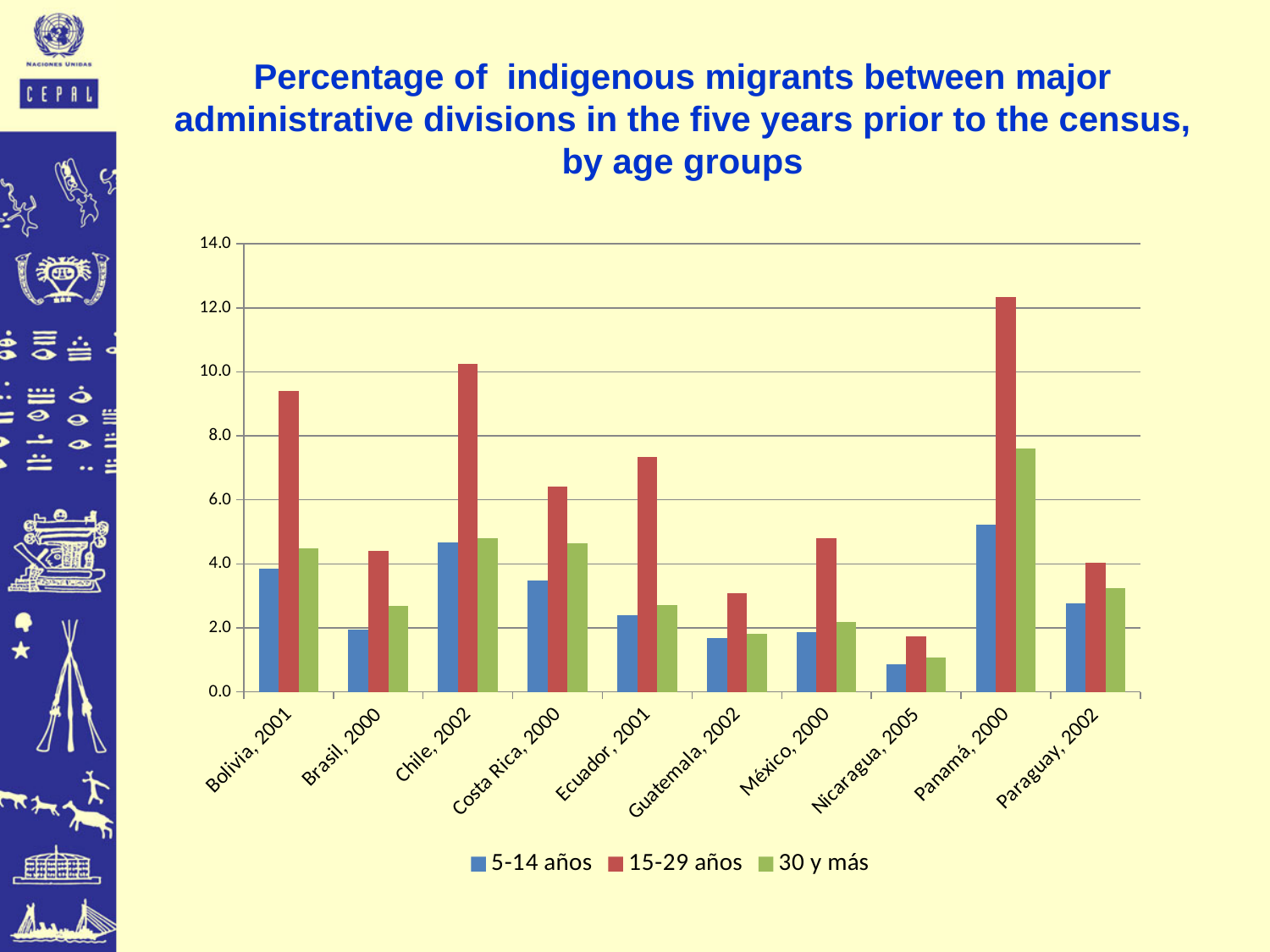
Is the 15-29 años value for Bolivia, 2001 greater or less than 8.0? greater Which is larger, the 5-14 años value for Panamá, 2000 or for Chile, 2002? Panamá, 2000 How many country-year categories are shown on the x axis? 10 Which category has the lowest value for the 15-29 años series? Nicaragua, 2005 Is the 30 y más value for Panamá, 2000 greater or less than 8.0? less Which category has the highest value for the 5-14 años series? Panamá, 2000 How many series does the legend list? 3 Is the 15-29 años value for Nicaragua, 2005 greater or less than 2.0? less Which category has the highest value for the 15-29 años series? Panamá, 2000 What kind of chart is shown on the slide? Bar chart What are the three series named in the legend? 5-14 años, 15-29 años, 30 y más Which is larger, the 15-29 años value for Bolivia, 2001 or for Chile, 2002? Chile, 2002